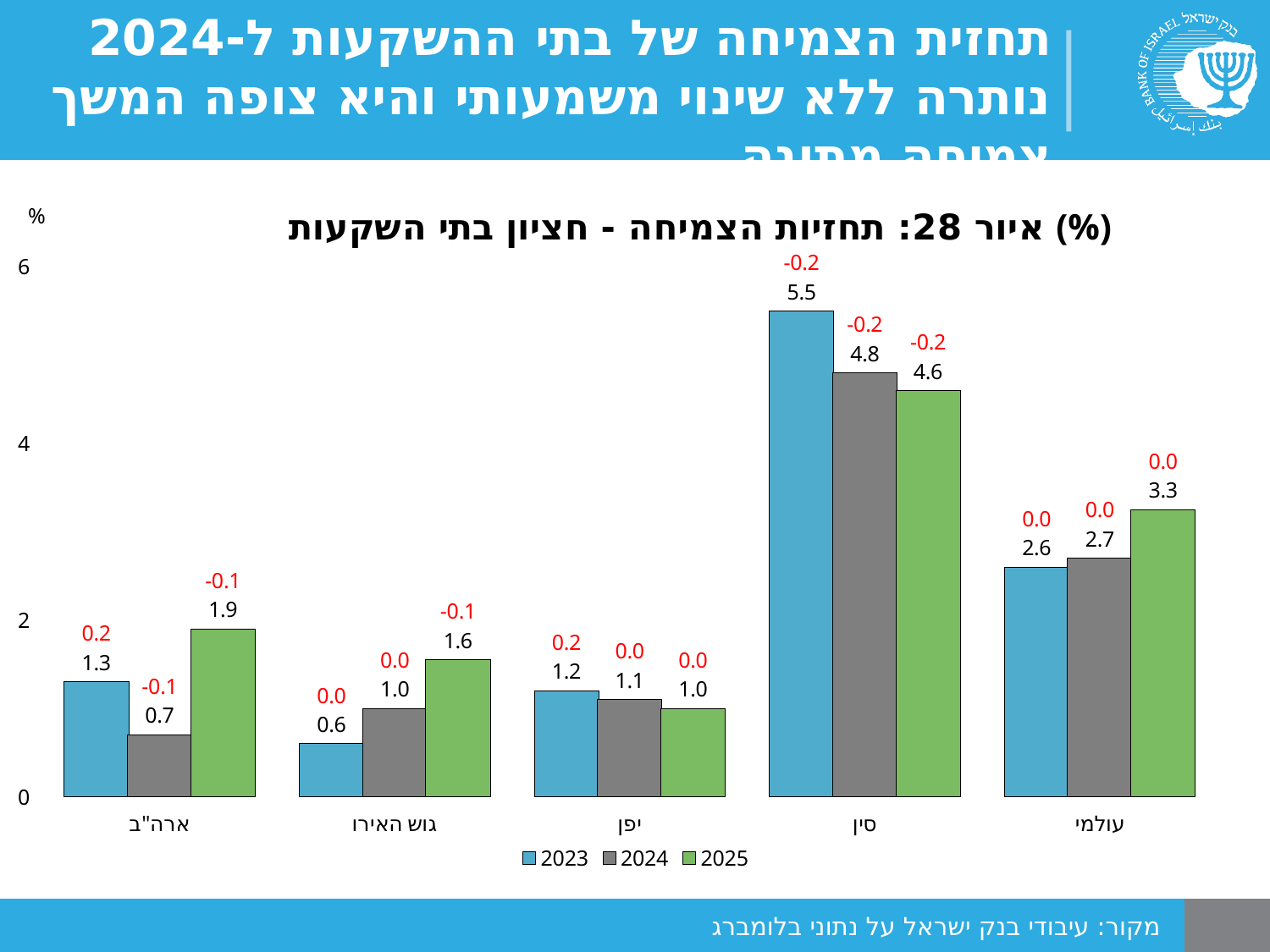
Is the 2025 value for ארה"ב (USA) greater or less than 2? less Do the values for יפן (Japan) rise or fall from 2023 to 2025? fall What is the difference between the 2023 and 2025 values for סין (China)? 0.9 What is the 2025 growth forecast value for סין (China)? 4.6 How many series does the legend list? 3 Which is larger for עולמי (Global): the 2024 value or the 2025 value? 2025 Which category has the highest 2023 value? סין How many categories are shown on the x axis? 5 What kind of chart is shown? bar chart Which category has the lowest 2023 value? גוש האירו What is the 2023 value for ארה"ב (USA)? 1.3 What is the 2024 value for גוש האירו (Eurozone)? 1.0